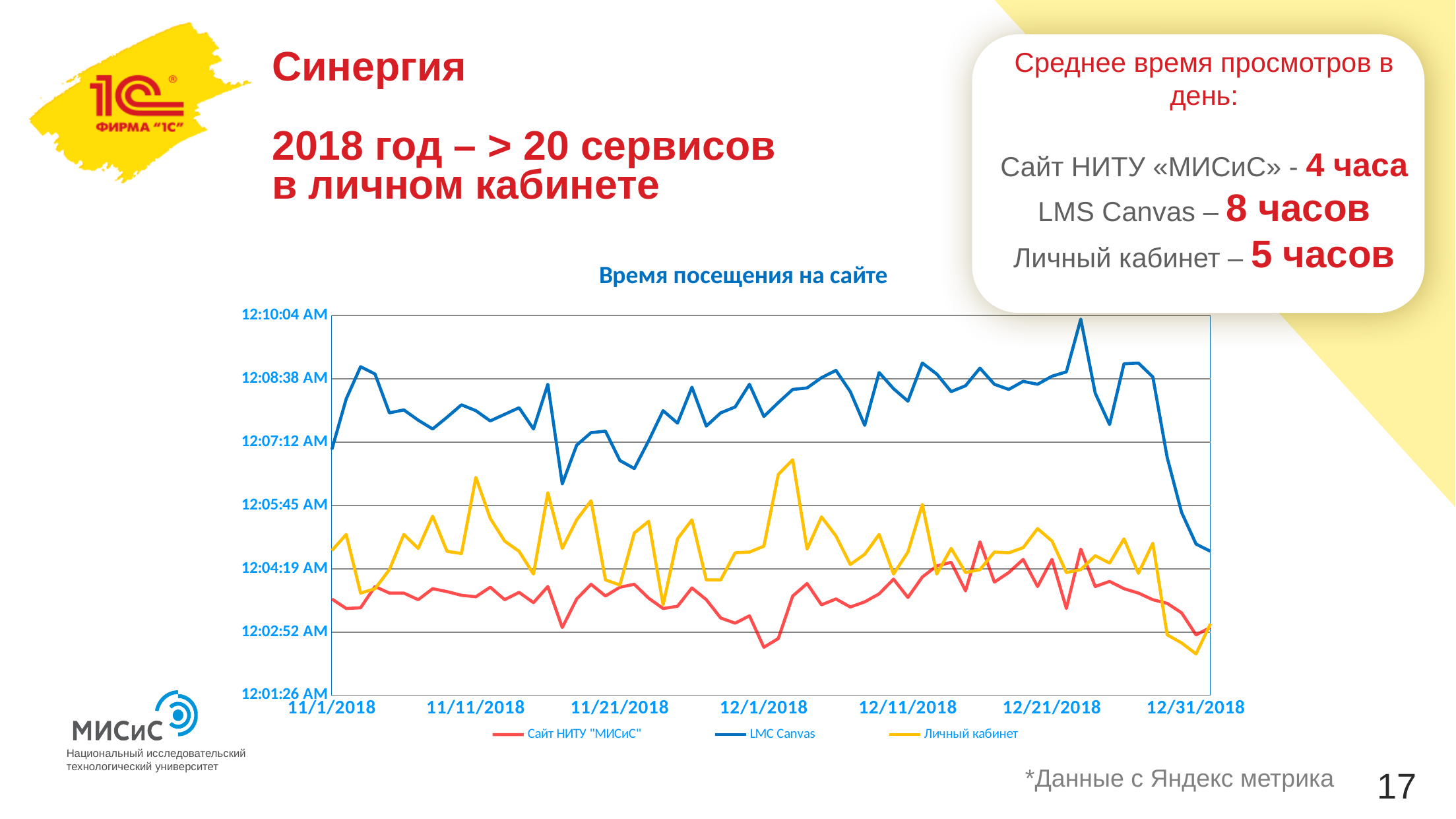
Is the value for Сайт НИТУ "МИСиС" at 12/1/2018 greater or less than 12:04:19 AM? less Which series is drawn in blue in the chart? LMC Canvas At 12/1/2018, which series has the larger value: Личный кабинет or Сайт НИТУ "МИСиС"? Личный кабинет Which series has the highest values for almost the entire period shown? LMC Canvas How many date labels are shown on the x axis of the chart? 7 What kind of chart is shown on the slide? line chart Does the LMC Canvas line rise or fall over the last days of December 2018? fall Is the value for LMC Canvas at 12/11/2018 greater or less than 12:05:45 AM? greater Which series has the lowest values for most of the period shown? Сайт НИТУ "МИСиС" What is the title of the chart? Время посещения на сайте At 12/11/2018, which series has the larger value: LMC Canvas or Сайт НИТУ "МИСиС"? LMC Canvas How many series does the chart legend list? 3